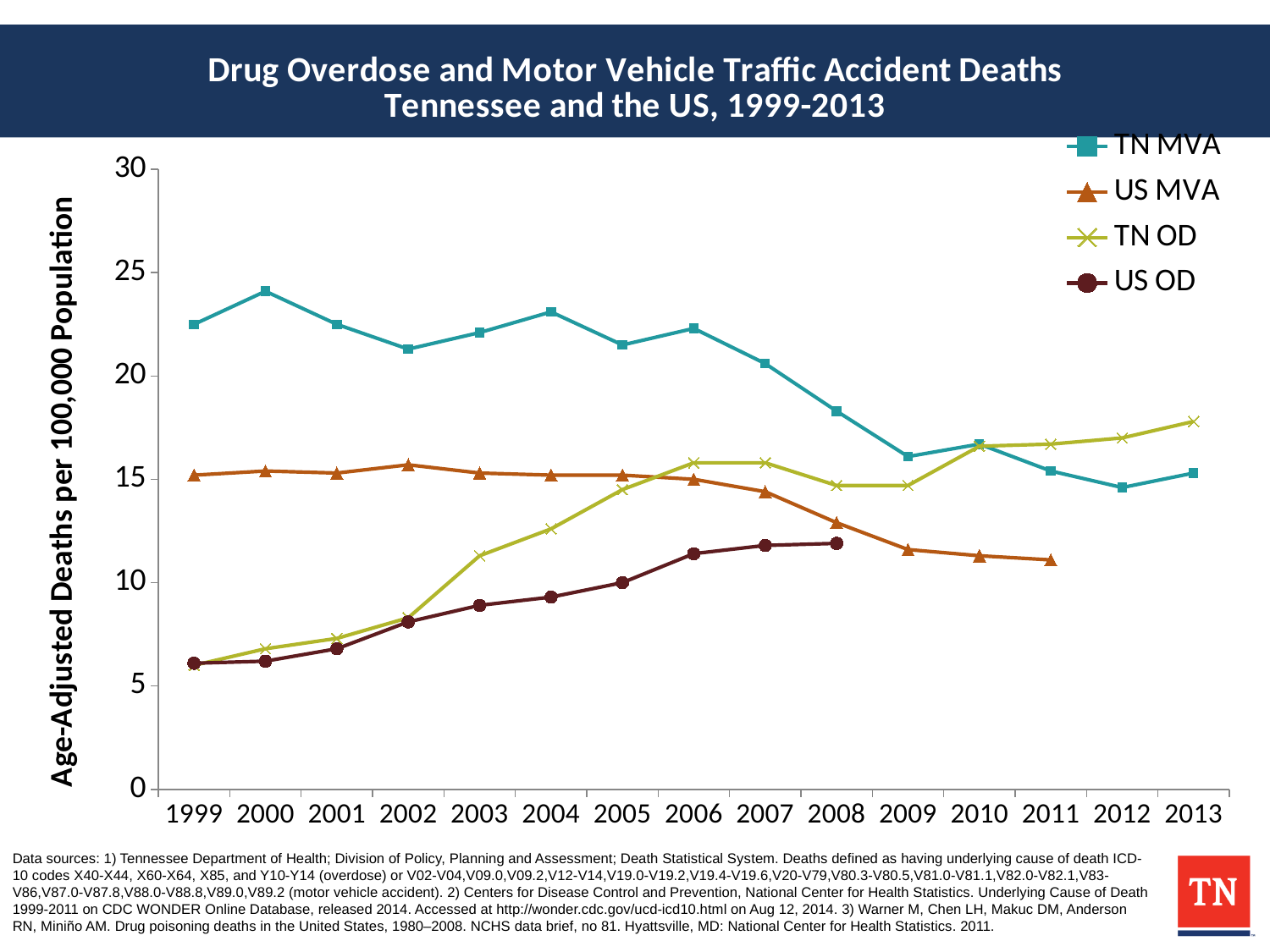
Which series has the highest value in 1999? TN MVA Does the TN MVA line rise or fall overall from 1999 to 2013? fall How many series does the legend list? 4 Is the value for TN MVA in 2000 greater or less than 20? greater In 2013, which is larger, TN OD or TN MVA? TN OD Which series has the lowest value in 2011? US MVA How many years are shown along the x axis? 15 What kind of chart is shown on the slide? line chart Is the value for TN OD in 1999 greater or less than 10? less Does the TN OD line rise or fall from 1999 to 2013? rise Is the value for US MVA in 2011 greater or less than 15? less What is the label of the y axis? Age-Adjusted Deaths per 100,000 Population